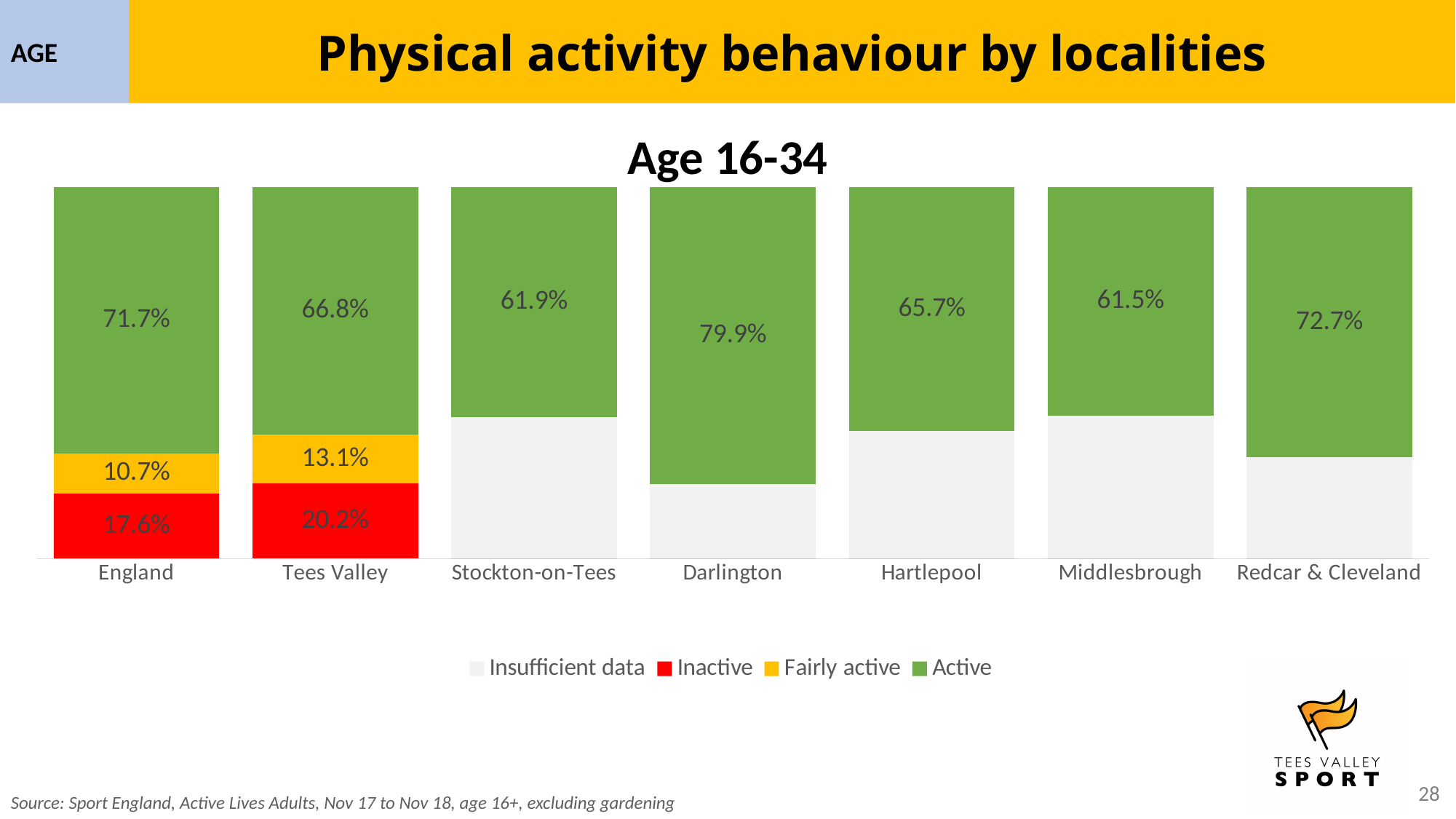
What is the Inactive percentage for Tees Valley? 20.2% Which has a higher Inactive percentage, England or Tees Valley? Tees Valley What kind of chart is shown on the slide? Stacked bar chart Which locality has the highest Active percentage? Darlington Which locality has the lowest Active percentage? Middlesbrough How many localities are shown on the x axis? 7 What is the Fairly active percentage for England? 10.7% What is the difference between the Active percentages for Darlington and Stockton-on-Tees? 18.0% How many series does the legend list? 4 What is the Active percentage for Darlington? 79.9% What is the Active percentage for Redcar & Cleveland? 72.7% What is the title of the chart? Age 16-34